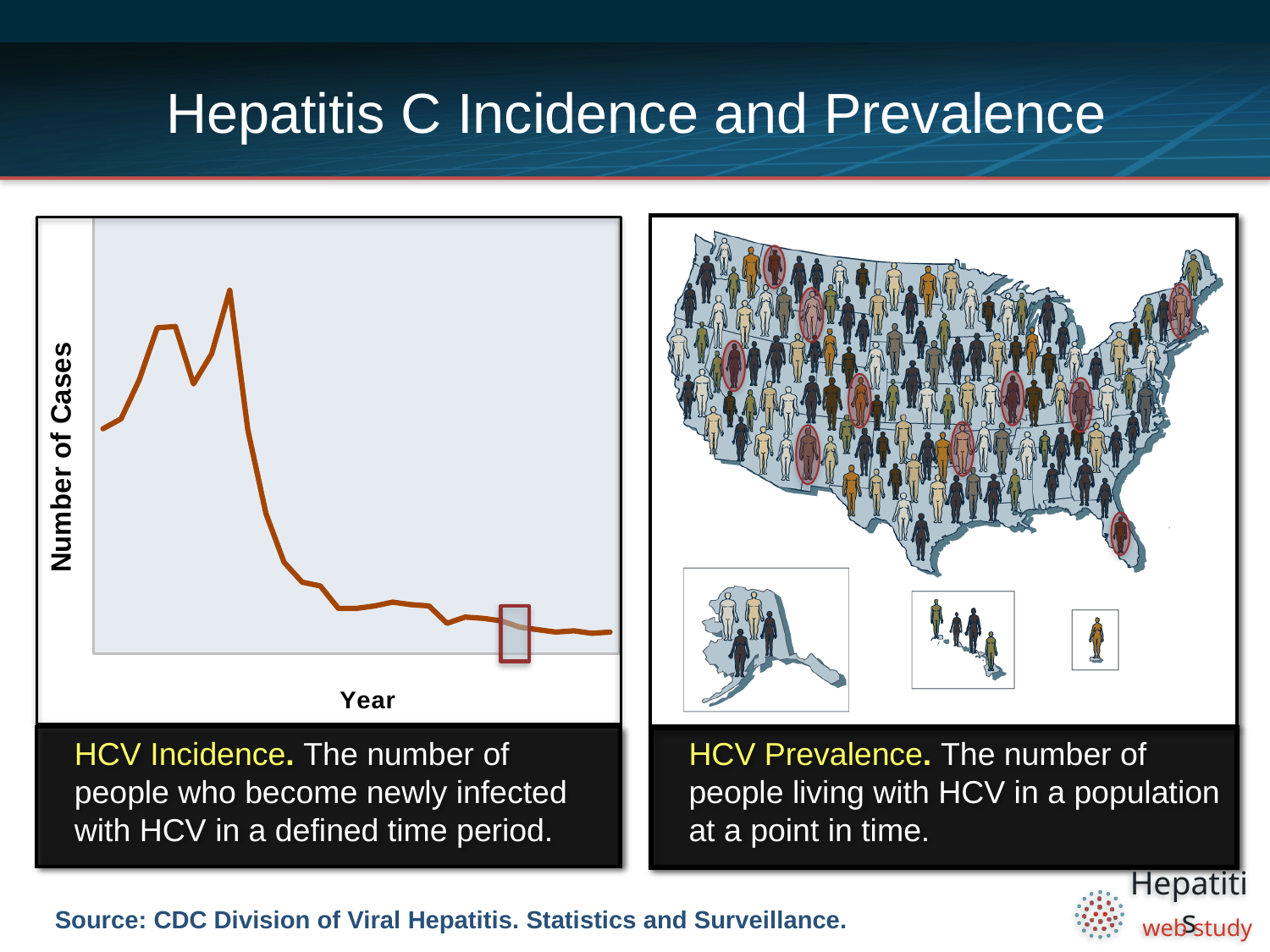
In the line chart on the left, is the peak of the line located in the left half or the right half of the x axis? left half In the line chart on the left, is the number of cases at the right end of the x axis higher or lower than at the left end? lower In the line chart on the left, do the values overall rise or fall from the left end of the x axis to the right end? fall How many lines are plotted in the line chart on the left? 1 In the line chart on the left, what is the label of the vertical axis? Number of Cases What kind of chart is shown on the left side of the slide? line chart In the line chart on the left, what is the label of the horizontal axis? Year In the line chart on the left, after the peak, does the number of cases rise or fall? fall